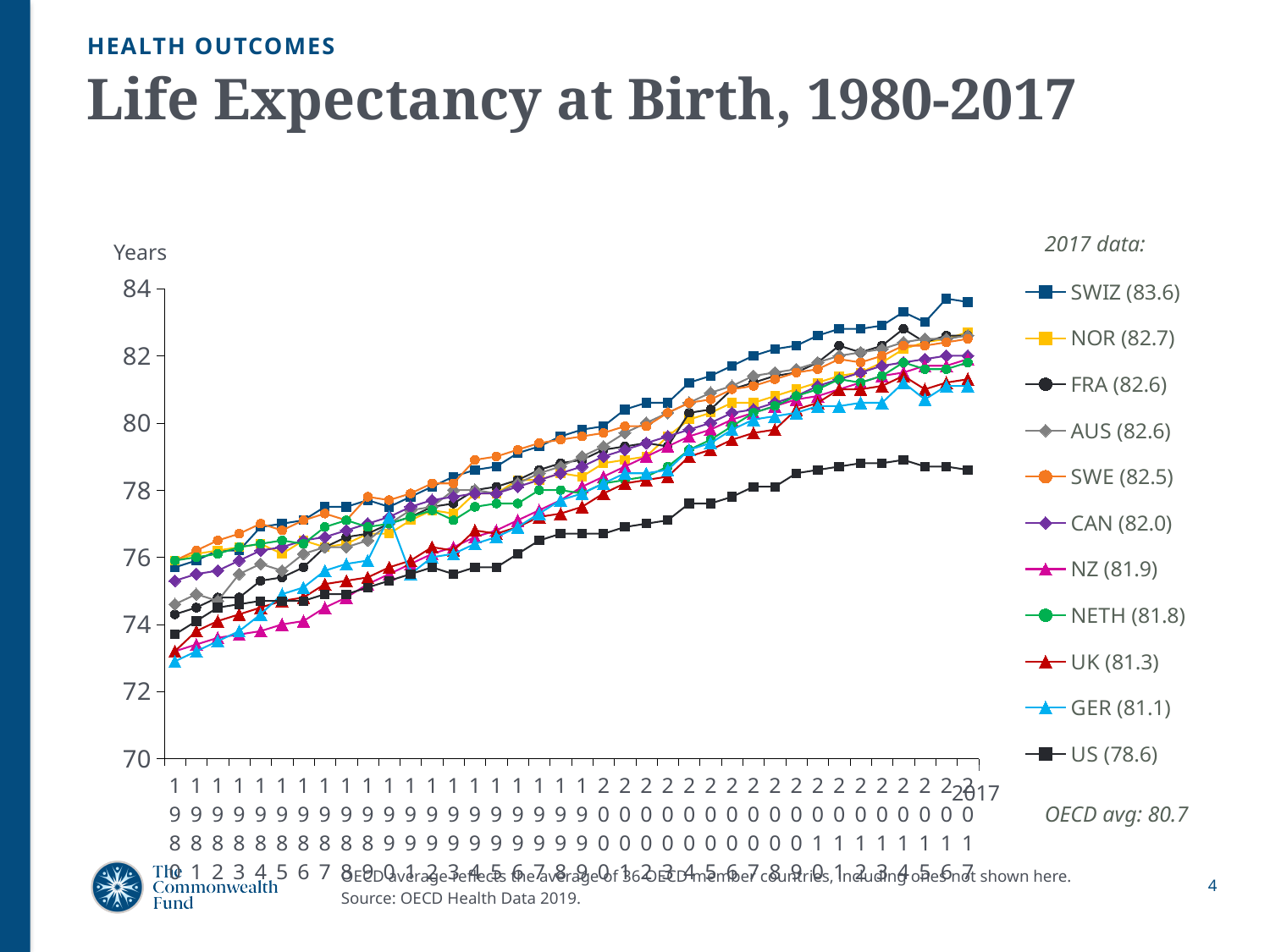
What is the difference between the 2017 life expectancy of SWIZ and the US? 5.0 Is the 2017 life expectancy for the US greater or less than 80? less What type of chart is used to show life expectancy at birth? Line chart What is the OECD average life expectancy shown on the slide? 80.7 How many countries are listed in the chart's legend? 11 Which country has the lowest life expectancy at birth in 2017? US According to the legend, what was the life expectancy at birth for SWIZ in 2017? 83.6 Which country has the highest life expectancy at birth in 2017? SWIZ Which had the higher life expectancy in 2017, NOR or FRA? NOR What is the difference between the 2017 life expectancy of CAN and GER? 0.9 What 2017 life expectancy value is shown for the US in the legend? 78.6 Is the life expectancy for GER in 1980 greater or less than 74? less